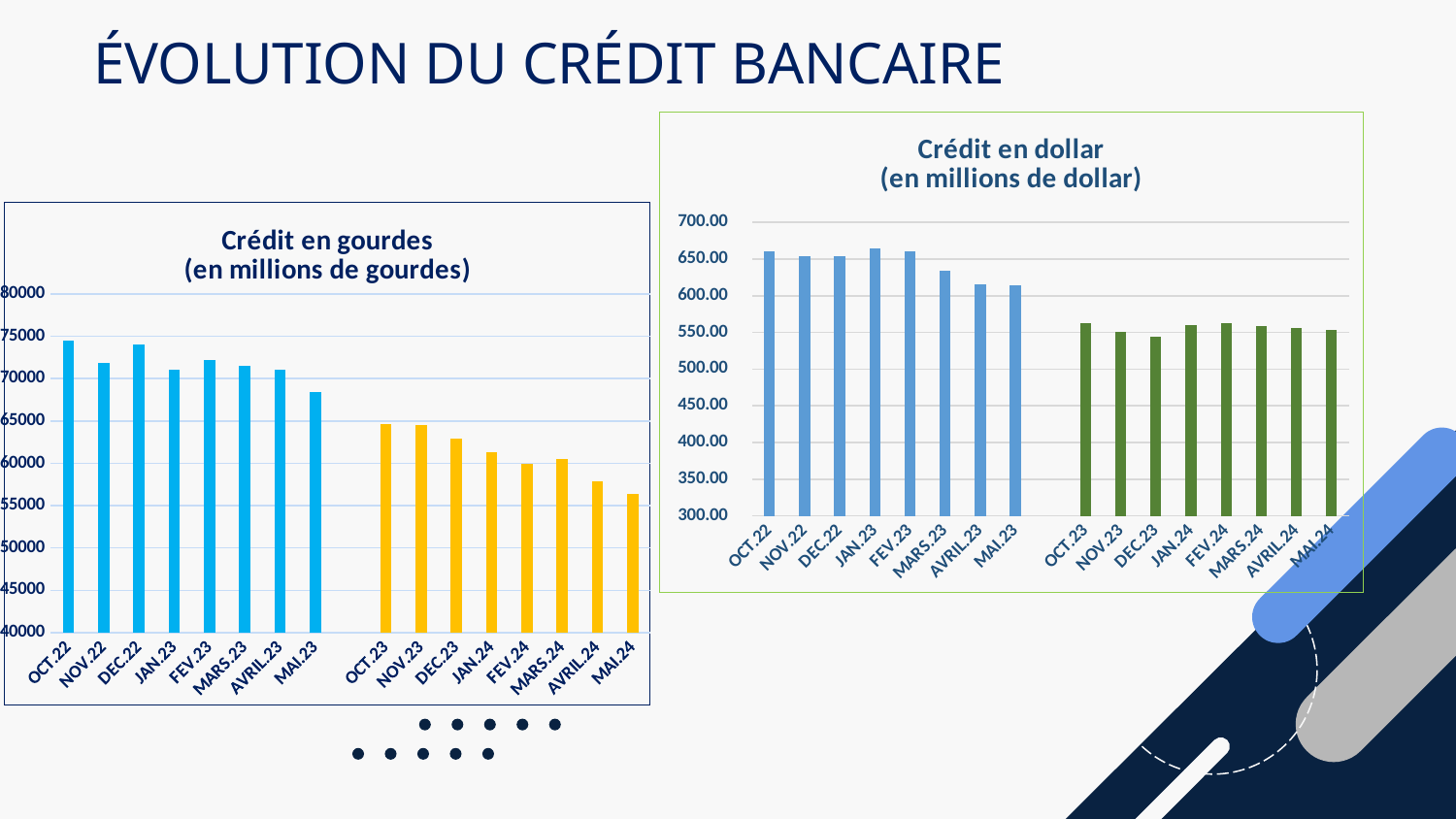
In the 'Crédit en gourdes' chart, which month has the lowest value? MAI.24 In the 'Crédit en gourdes' chart, is the value for MAI.24 greater or less than 60000? less How many bars are plotted in the 'Crédit en gourdes' chart? 16 In the 'Crédit en dollar' chart, which is larger, the value for MAI.23 or the value for OCT.23? MAI.23 In the 'Crédit en gourdes' chart, is the value for OCT.22 greater or less than 70000? greater In the 'Crédit en dollar' chart, is the value for OCT.22 greater or less than 650.00? greater What is the title of the chart on the left of the slide? Crédit en gourdes (en millions de gourdes) In the 'Crédit en gourdes' chart, which is larger, the value for OCT.22 or the value for OCT.23? OCT.22 What kind of chart is the 'Crédit en dollar' chart? Bar chart In the 'Crédit en dollar' chart, do the values generally rise or fall from OCT.22 to MAI.24? Fall